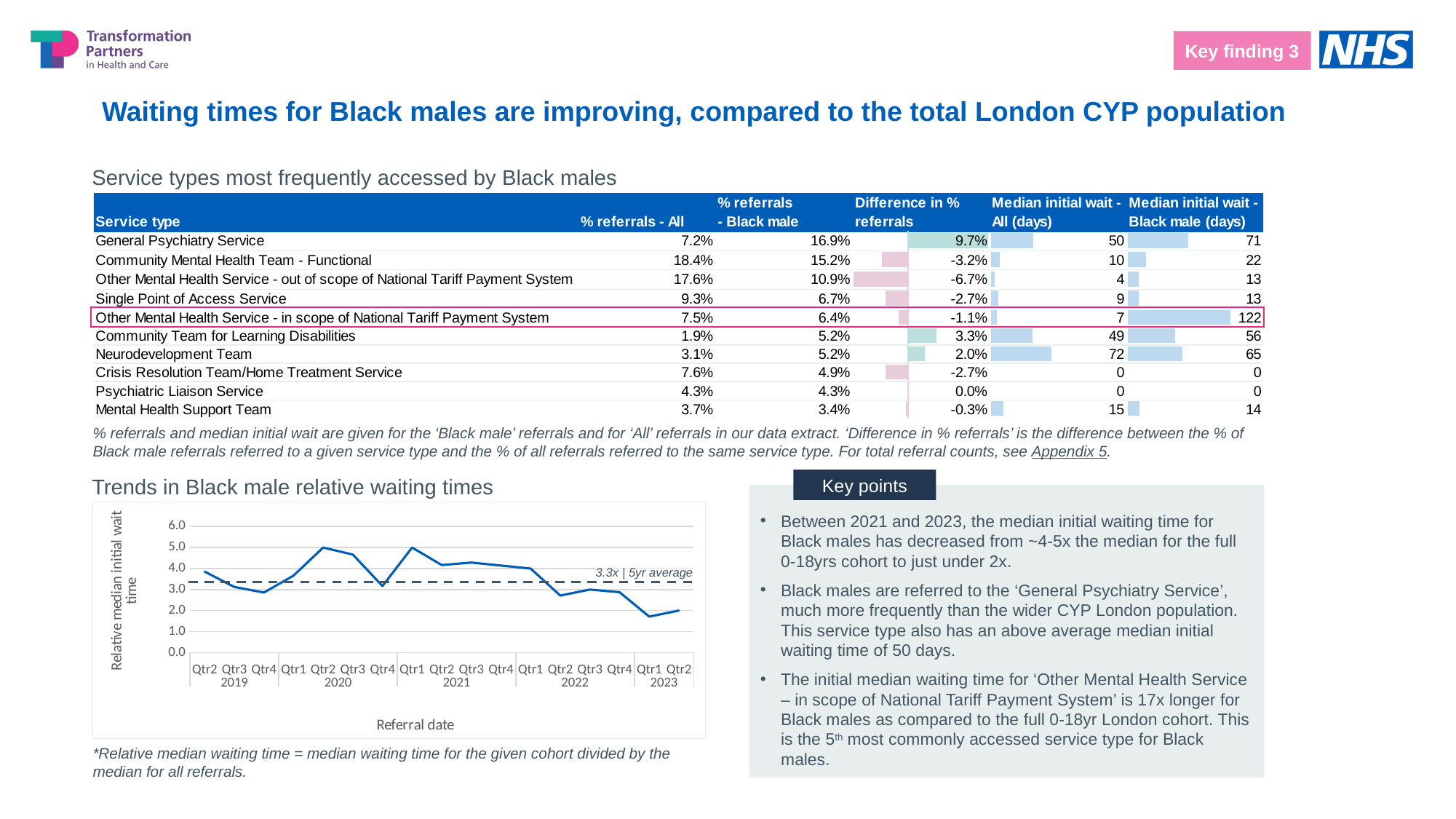
In the 'Trends in Black male relative waiting times' chart, is the value for Qtr1 2023 greater or less than 2.0? less In the 'Trends in Black male relative waiting times' chart, which quarter has the lowest relative median initial wait time? Qtr1 2023 In the 'Trends in Black male relative waiting times' chart, is the value for Qtr2 2020 greater or less than 4.0? greater In the 'Trends in Black male relative waiting times' chart, which is larger: the value for Qtr2 2020 or the value for Qtr1 2023? Qtr2 2020 In the 'Trends in Black male relative waiting times' chart, what value is given for the 5yr average? 3.3x How many quarterly data points are plotted in the 'Trends in Black male relative waiting times' chart? 17 In the 'Trends in Black male relative waiting times' chart, is the value for Qtr1 2021 greater or less than 4.0? greater What is the x-axis title of the 'Trends in Black male relative waiting times' chart? Referral date In the 'Trends in Black male relative waiting times' chart, do the values overall rise or fall from 2021 to 2023? fall What kind of chart is 'Trends in Black male relative waiting times'? line chart